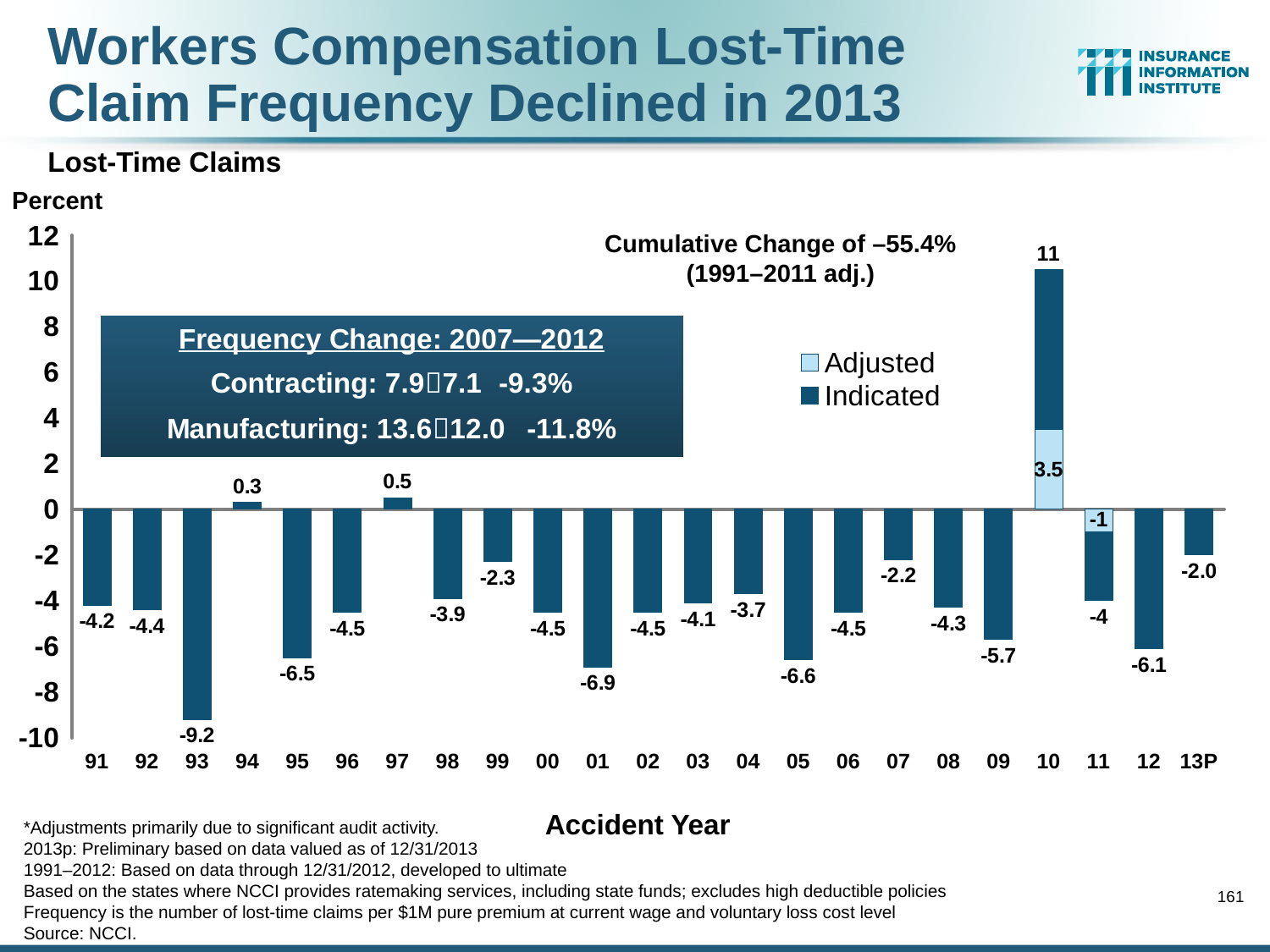
What is the value for accident year 13P? -2.0 What is the value for accident year 07? -2.2 What is the value for accident year 93? -9.2 How many series does the legend list? 2 What is the value for accident year 97? 0.5 Which accident year has the highest value? 10 How many accident years are shown on the x axis? 23 Which accident year has the lowest (most negative) value? 93 What is the difference between the values for accident years 01 and 05? 0.3 Which accident year shows a larger decline, 95 or 12? 95 What is the Adjusted value for accident year 10? 3.5 What kind of chart is shown on the slide? Bar chart